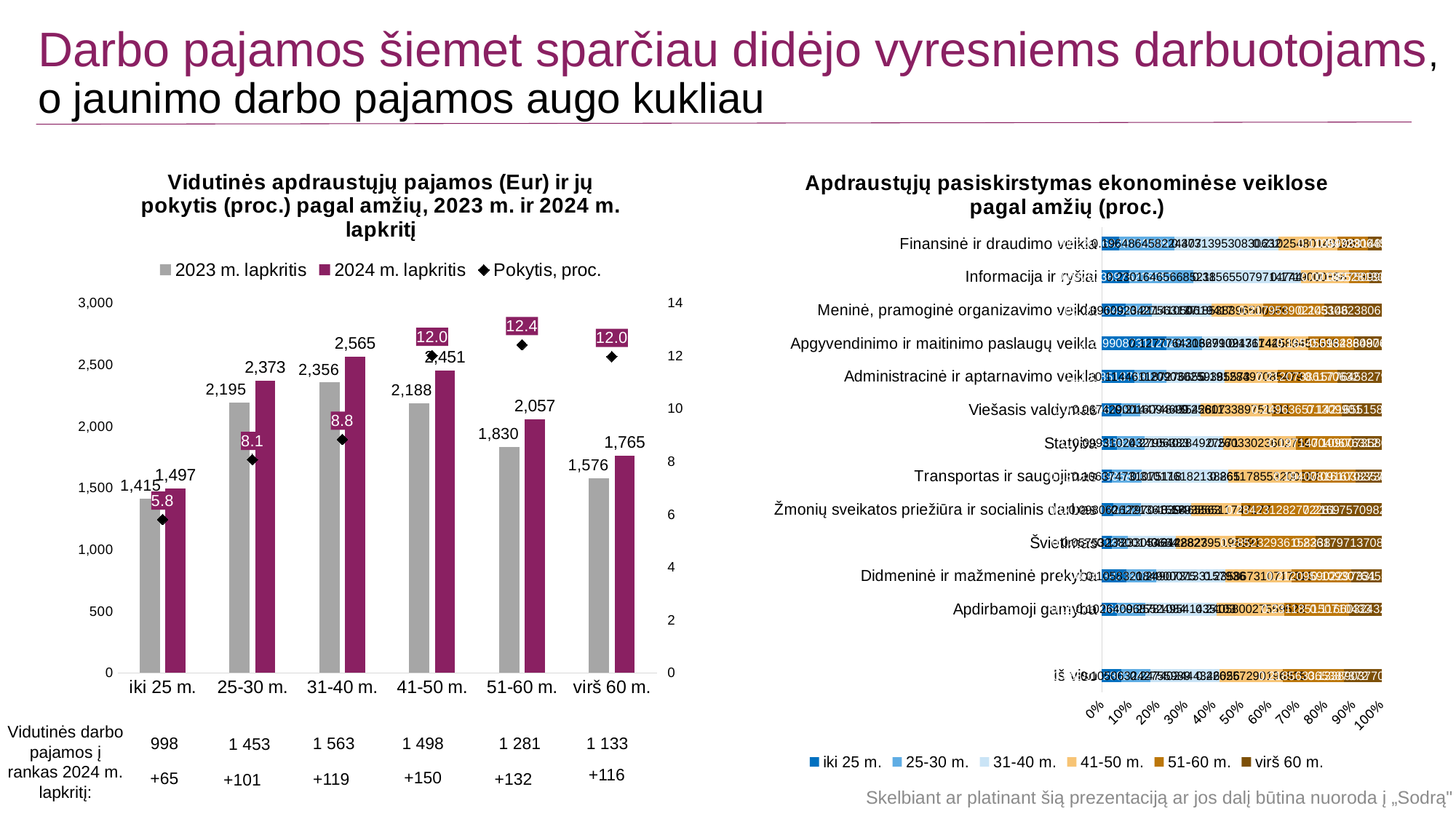
In the left chart, how many series does the legend list? 3 What kind of chart is the right chart 'Apdraustųjų pasiskirstymas ekonominėse veiklose pagal amžių (proc.)'? Stacked bar chart In the left chart, how does the Pokytis, proc. value change from iki 25 m. to 51-60 m.? It rises In the right chart 'Apdraustųjų pasiskirstymas ekonominėse veiklose pagal amžių (proc.)', how many series does the legend list? 6 In the left chart, what is the Pokytis, proc. value for the 51-60 m. age group? 12.4 In the left chart 'Vidutinės apdraustųjų pajamos (Eur) ir jų pokytis (proc.) pagal amžių', what is the 2024 m. lapkritis value for the 31-40 m. age group? 2,565 In the left chart, which age group has the lowest Pokytis, proc. value? iki 25 m. In the left chart, what is the difference between the 2024 m. lapkritis and 2023 m. lapkritis values for the 41-50 m. age group? 263 In the left chart, which age group has the highest 2024 m. lapkritis value? 31-40 m. In the left chart, which is larger: the 2023 m. lapkritis value for 25-30 m. or for 41-50 m.? 25-30 m. In the left chart, how many age groups are shown on the x axis? 6 In the left chart, what is the 2023 m. lapkritis value for the iki 25 m. age group? 1,415